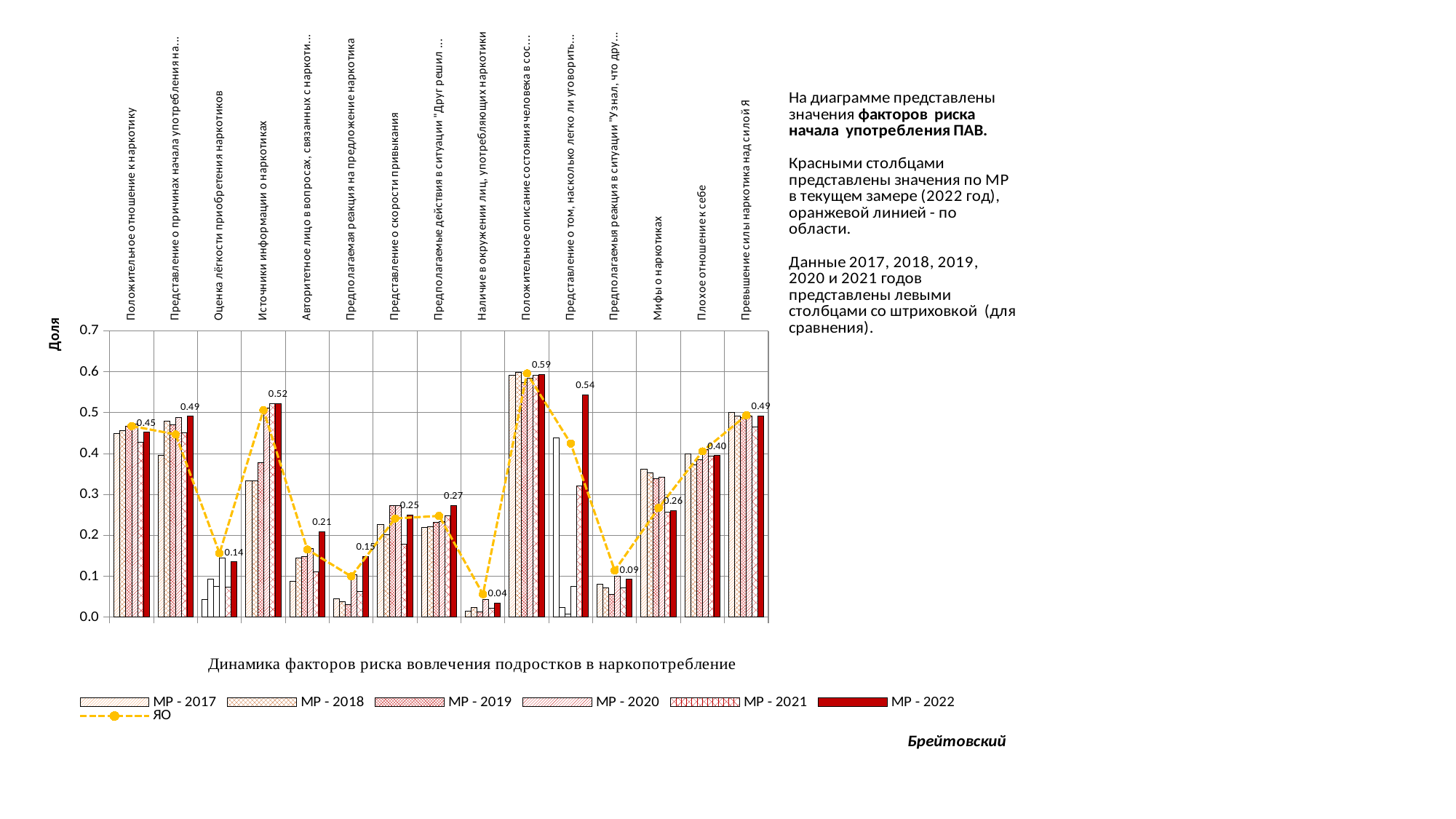
What is the difference between the МР - 2022 values for "Источники информации о наркотиках" and "Оценка лёгкости приобретения наркотиков"? 0.38 How many categories are shown on the x axis? 15 What is the МР - 2022 value for "Мифы о наркотиках"? 0.26 Which series is drawn as a dashed line with markers? ЯО What is the МР - 2022 value for "Плохое отношение к себе"? 0.40 What is the МР - 2022 value for "Источники информации о наркотиках"? 0.52 What is the МР - 2022 value for "Положительное отношение к наркотику"? 0.45 Is the ЯО value for "Мифы о наркотиках" greater or less than 0.2? greater How many series does the legend list? 7 Which has the larger МР - 2022 value: "Превышение силы наркотика над силой Я" or "Плохое отношение к себе"? Превышение силы наркотика над силой Я Which category has the lowest МР - 2022 value? Наличие в окружении лиц, употребляющих наркотики Is the ЯО value for "Оценка лёгкости приобретения наркотиков" greater or less than 0.2? less